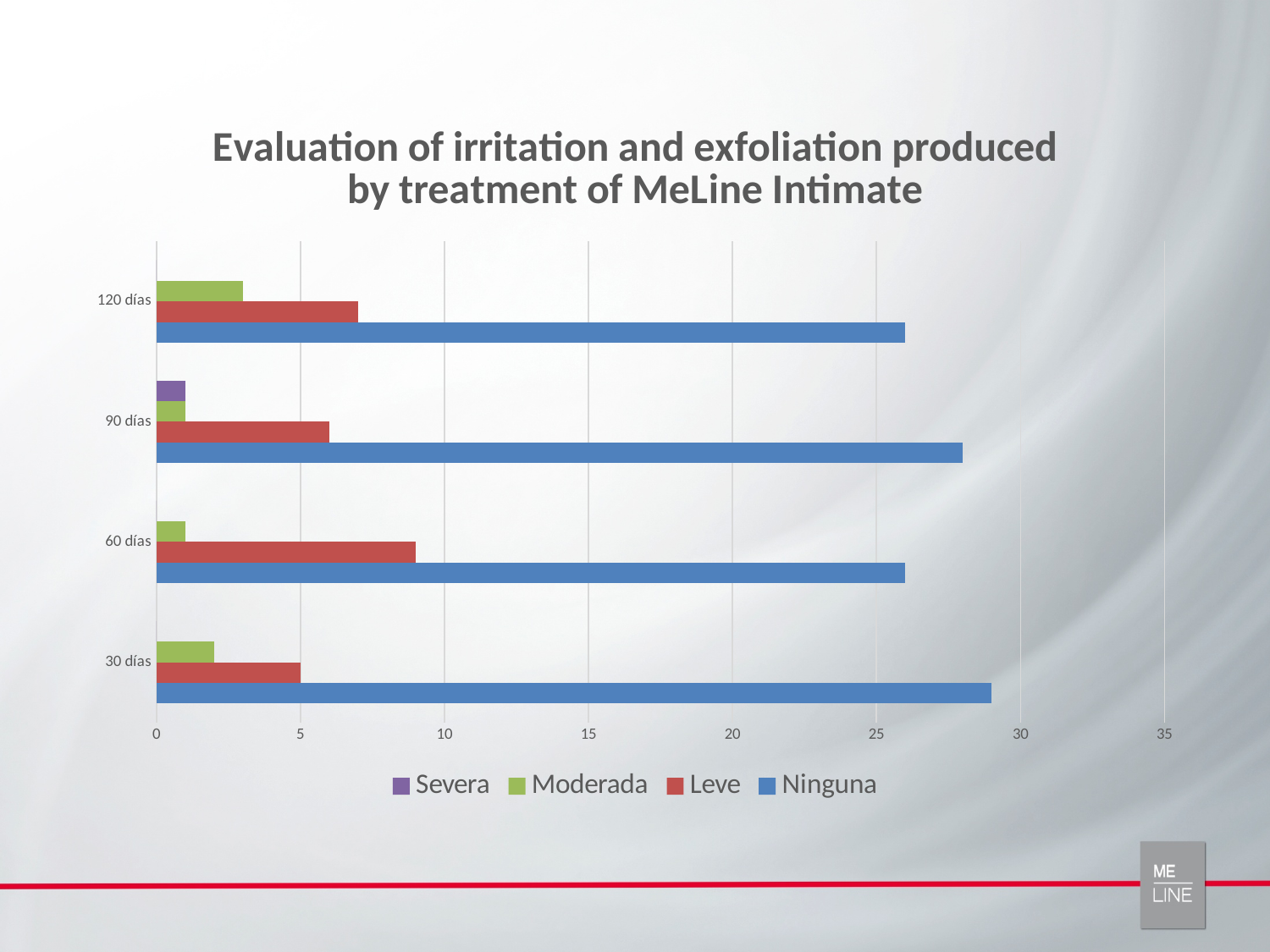
Which category has the highest Leve value? 60 días How many series does the legend list? 4 Which category is the only one with a visible Severa bar? 90 días Which series is shown in blue? Ninguna Which is larger, the Ninguna value at 90 días or at 60 días? 90 días Is the value for Ninguna at 30 días greater or less than 25? greater What kind of chart is shown on the slide? bar chart Is the value for Moderada at 120 días greater or less than 5? less Which category has the lowest Leve value? 30 días Is the value for Leve at 60 días greater or less than 10? less What is the value for Leve at 30 días? 5 How many time-point categories are shown on the y axis? 4